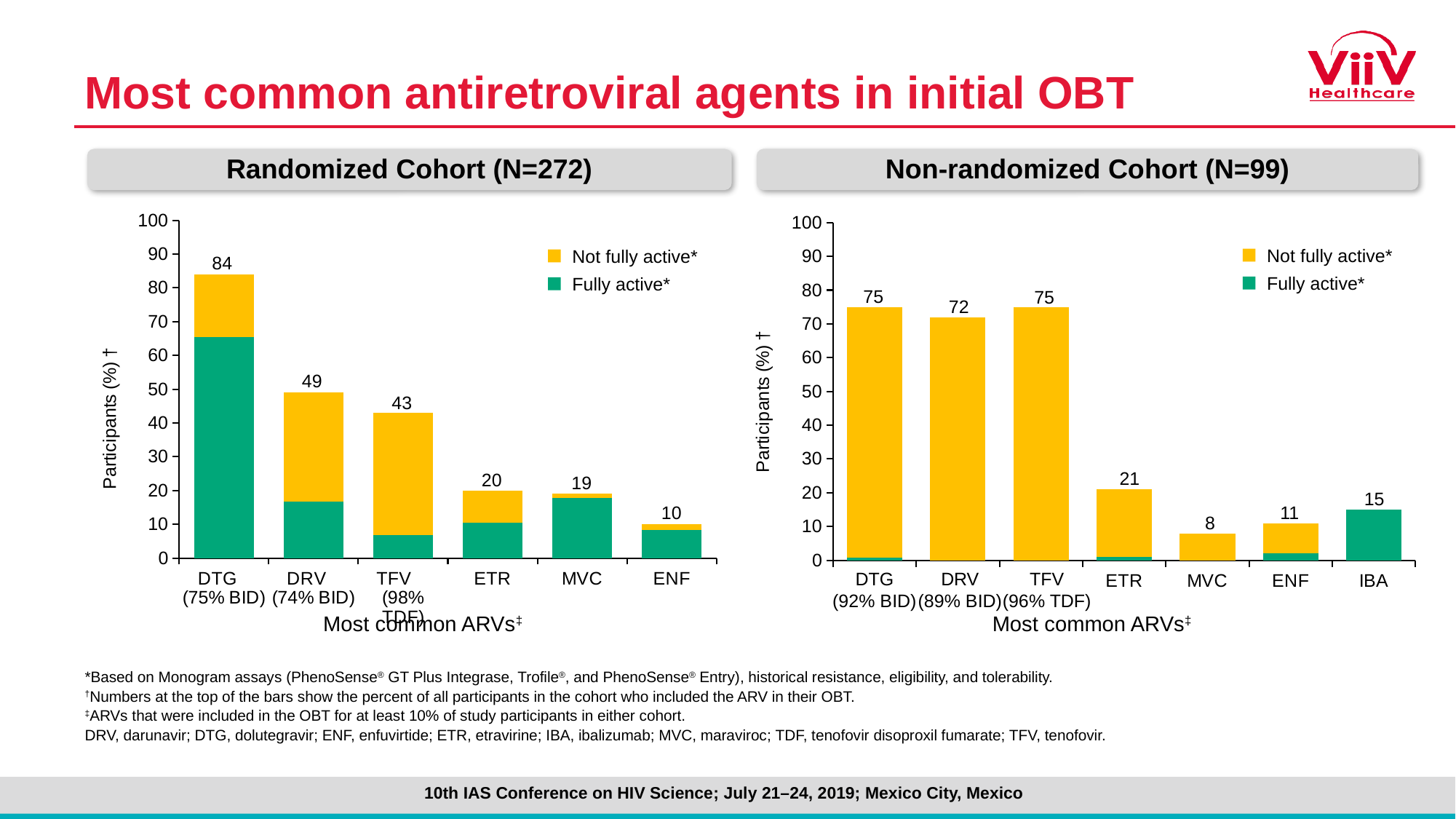
In the Non-randomized Cohort (N=99) chart, which bar is taller, ENF or IBA? IBA How many ARV categories are shown on the x axis of the Non-randomized Cohort (N=99) chart? 7 In the Randomized Cohort (N=272) chart, what is the difference between the DRV and TFV bar totals? 6 In the Non-randomized Cohort (N=99) chart, which colour represents the Not fully active series? Yellow How many series does the legend of the Randomized Cohort (N=272) chart list? 2 What type of chart is used for the Randomized Cohort (N=272)? Stacked bar chart In the Non-randomized Cohort (N=99) chart, what is the value labelled for DRV? 72 In the Randomized Cohort (N=272) chart, is the Fully active portion of the DTG bar greater or less than 60? greater In the Non-randomized Cohort (N=99) chart, is the Fully active portion of the DTG bar greater or less than 10? less In the Randomized Cohort (N=272) chart, what is the total percentage of participants whose OBT included DTG? 84 In the Non-randomized Cohort (N=99) chart, which ARV has the lowest bar? MVC In the Randomized Cohort (N=272) chart, which ARV has the highest bar? DTG